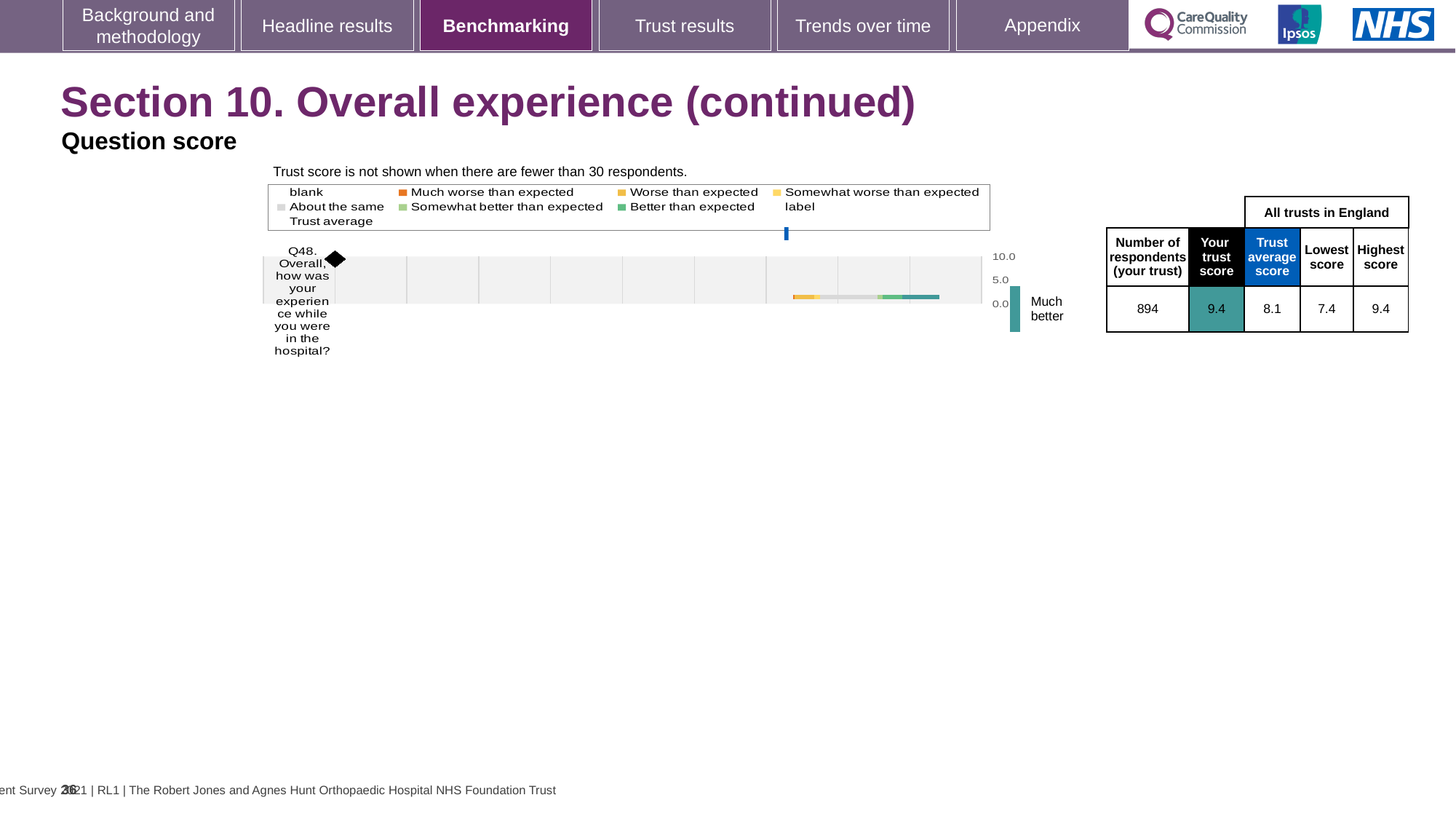
Is your trust score for Q48 greater or less than 5.0? greater According to the note above the chart, the trust score is not shown when there are fewer than how many respondents? 30 What is the difference between your trust score and the trust average score for Q48? 1.3 What is the number of respondents for your trust for Q48? 894 What is the lowest score for Q48 across all trusts in England? 7.4 Which is larger for Q48, your trust score or the trust average score? Your trust score What is the trust average score for Q48 across all trusts in England? 8.1 How many questions are plotted in the question score chart? 1 What is your trust score for Q48? 9.4 Which question is plotted in the question score chart? Q48. Overall, how was your experience while you were in the hospital? What is the highest score for Q48 across all trusts in England? 9.4 What kind of chart is used to show the Q48 question score? bar chart